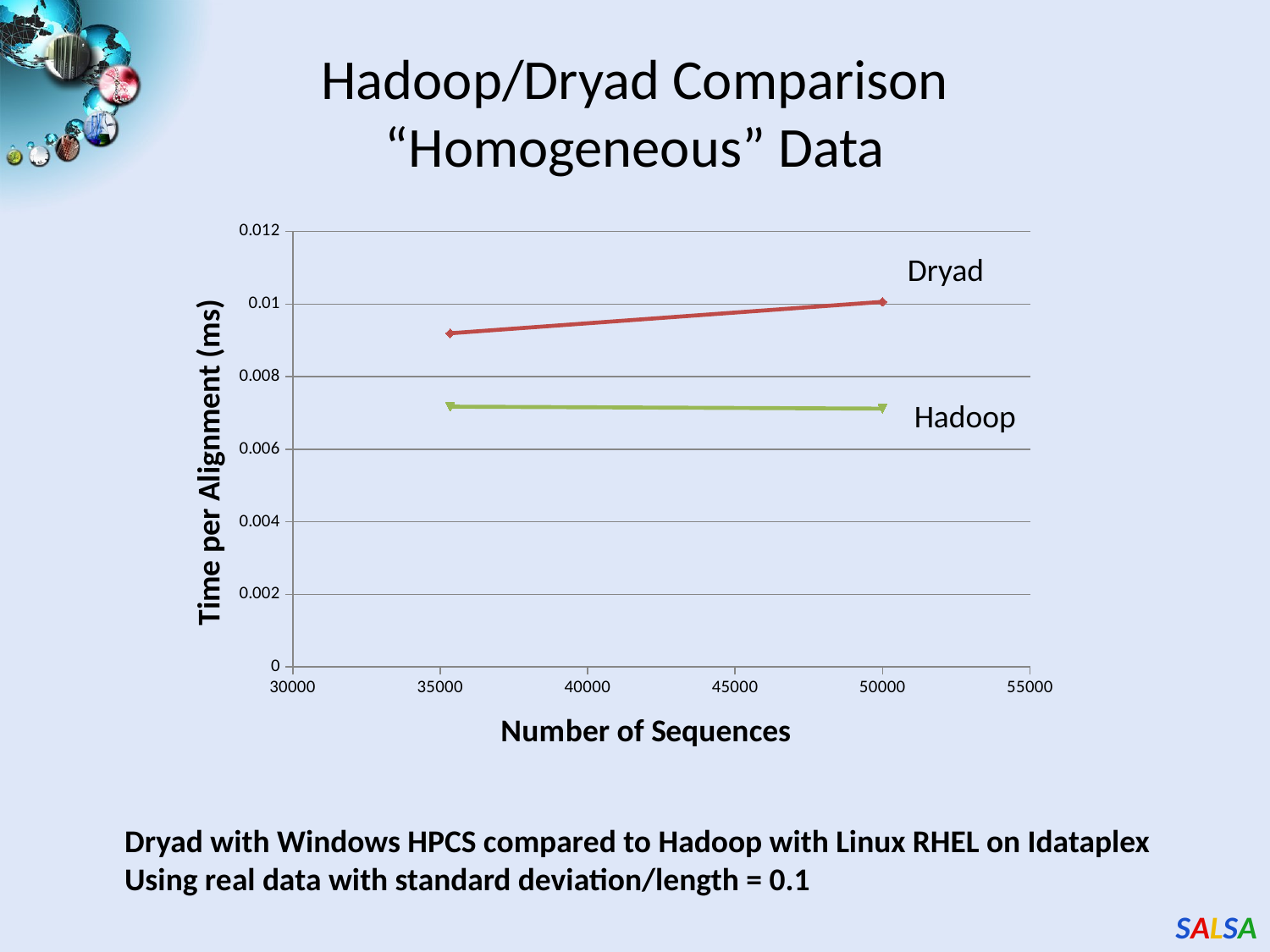
Is the Dryad value at 35000 sequences greater or less than 0.008 ms? greater How many series are plotted on the chart? 2 Which series has the higher time per alignment across the plotted range, Dryad or Hadoop? Dryad What is the label of the y axis? Time per Alignment (ms) Which series has the lowest time per alignment? Hadoop Is the Dryad value at 50000 sequences greater or less than 0.008 ms? greater How many data points are plotted for each series? 2 What is the label of the x axis? Number of Sequences What kind of chart is shown on the slide? line chart Does the Dryad line rise or fall as the number of sequences increases? rise Is the Hadoop value at 50000 sequences greater or less than 0.008 ms? less